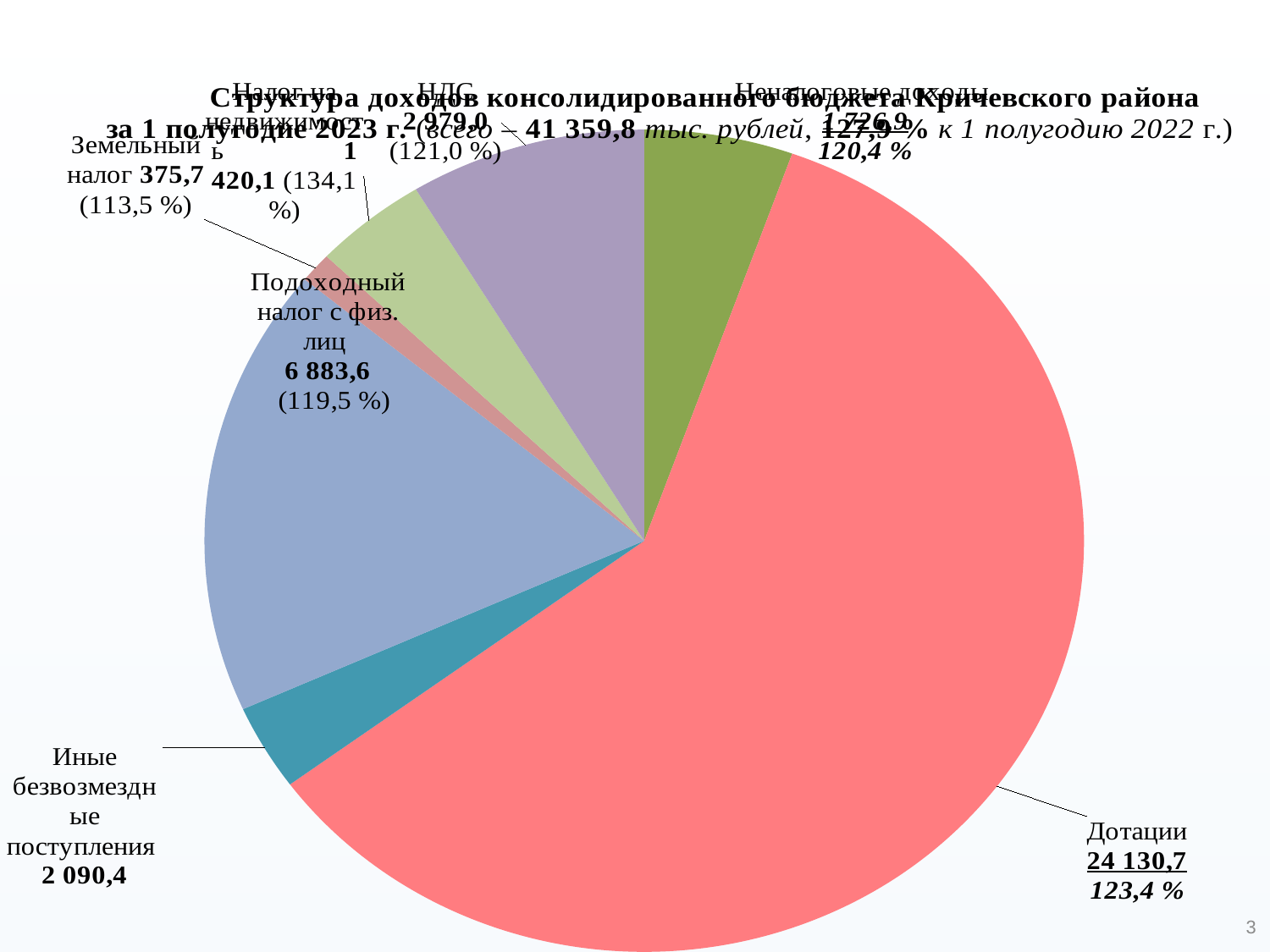
What is the difference between the values for НДС and Неналоговые доходы? 1 252,1 What is the difference between the values for Дотации and Подоходный налог с физ. лиц? 17 247,1 Which is larger, the value for Налог на недвижимость or the value for Земельный налог? Налог на недвижимость How many slices does the pie chart have? 7 What is the value shown for Дотации? 24 130,7 Which category has the largest slice of the pie? Дотации What is the value shown for Иные безвозмездные поступления? 2 090,4 What is the value shown for НДС? 2 979,0 Which category has the smallest slice of the pie? Земельный налог What type of chart is shown on the slide? pie chart According to the chart title, what is the total income (всего) for the first half of 2023? 41 359,8 тыс. рублей What is the value shown for Подоходный налог с физ. лиц? 6 883,6